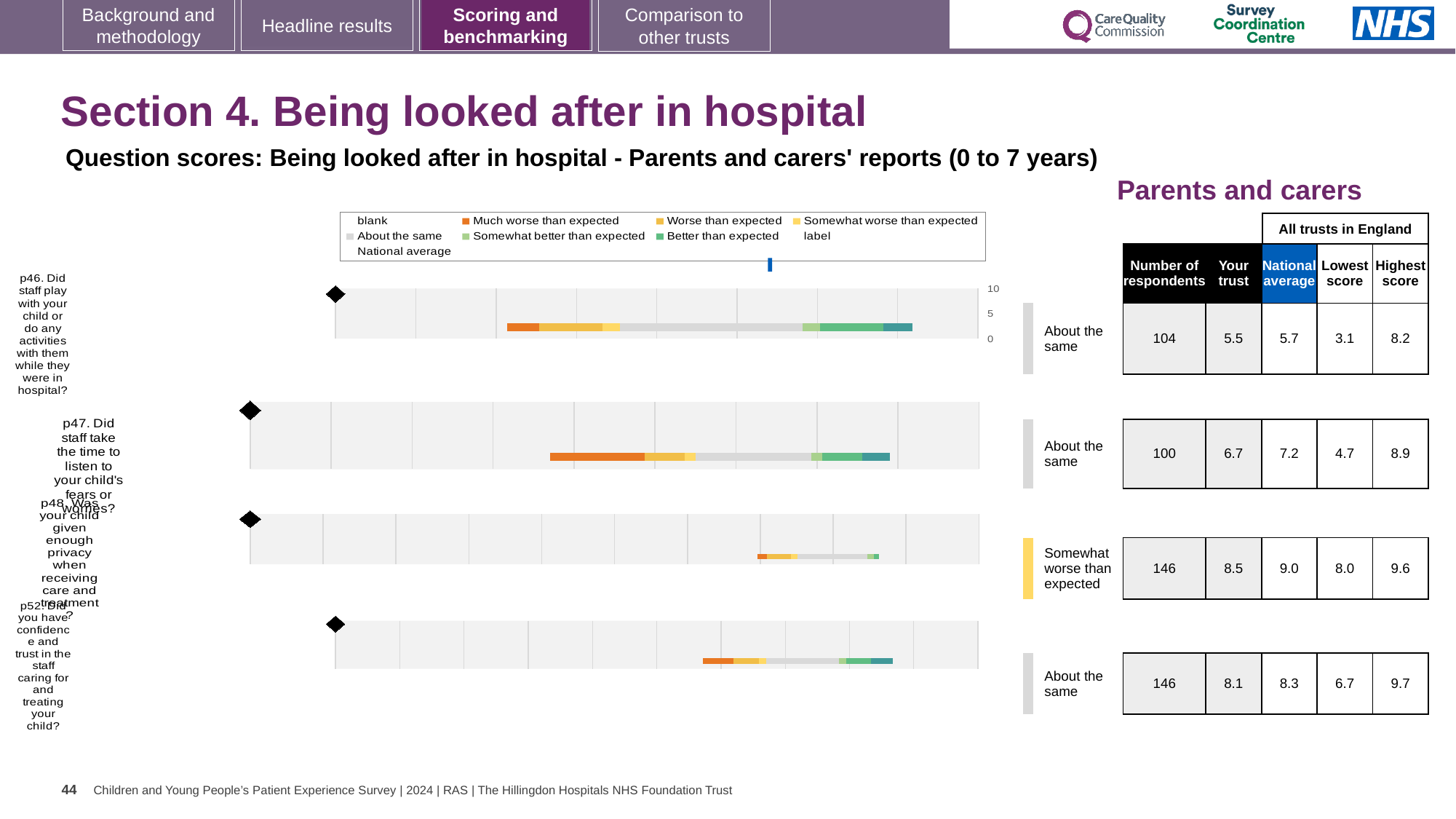
How many entries does the chart legend list? 9 Which question has the highest 'Your trust' score? p48 How many survey questions (chart rows) are plotted on the slide? 4 How many respondents answered p48 (Was your child given enough privacy when receiving care and treatment)? 146 Which question is rated 'Somewhat worse than expected'? p48 What is the difference between the highest score (8.2) and the lowest score (3.1) for p46? 5.1 What is the national average score for p47 (Did staff take the time to listen to your child's fears or worries)? 7.2 What kind of chart is used to show the question scores on this slide? bar chart Which question has the lowest 'Your trust' score? p46 What is the 'Your trust' score for p46 (Did staff play with your child or do any activities with them while they were in hospital)? 5.5 For p47, is the 'Your trust' score higher or lower than the national average? lower What is the highest score across all trusts in England for p52 (Did you have confidence and trust in the staff caring for and treating your child)? 9.7